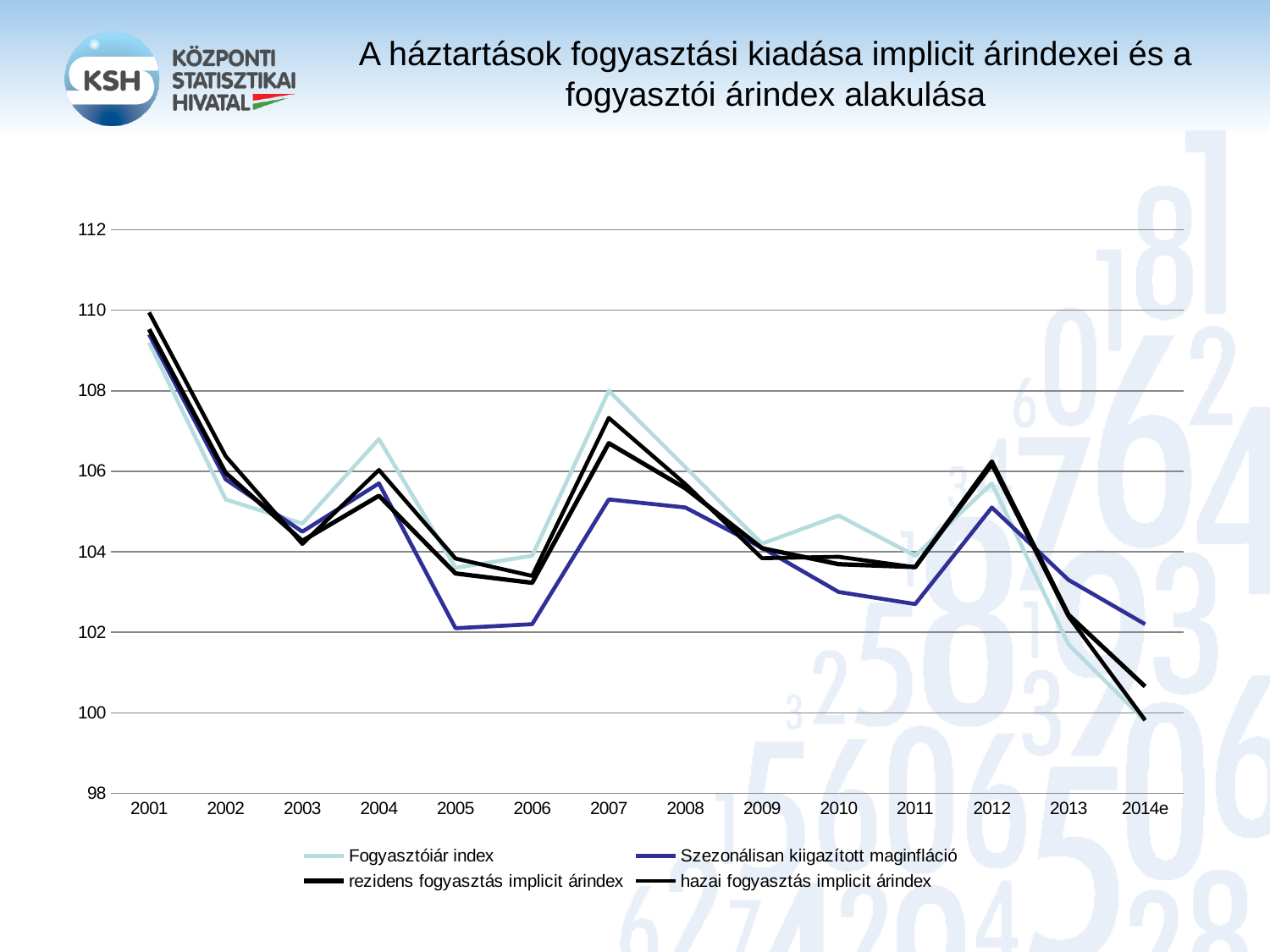
Is the value of the Fogyasztóiár index in 2014e greater or less than 102? less How many years are shown along the x axis? 14 What kind of chart is shown on the slide? line chart Is the value of the Fogyasztóiár index in 2001 greater or less than 108? greater What is the label of the last point on the x axis? 2014e In which year is the Fogyasztóiár index at its highest? 2001 Does the Fogyasztóiár index rise or fall from 2012 to 2014e? fall How many series does the legend list? 4 In which year is the Fogyasztóiár index at its lowest? 2014e Which series is drawn in light blue according to the legend? Fogyasztóiár index Is the value of the Fogyasztóiár index in 2004 greater or less than 106? greater